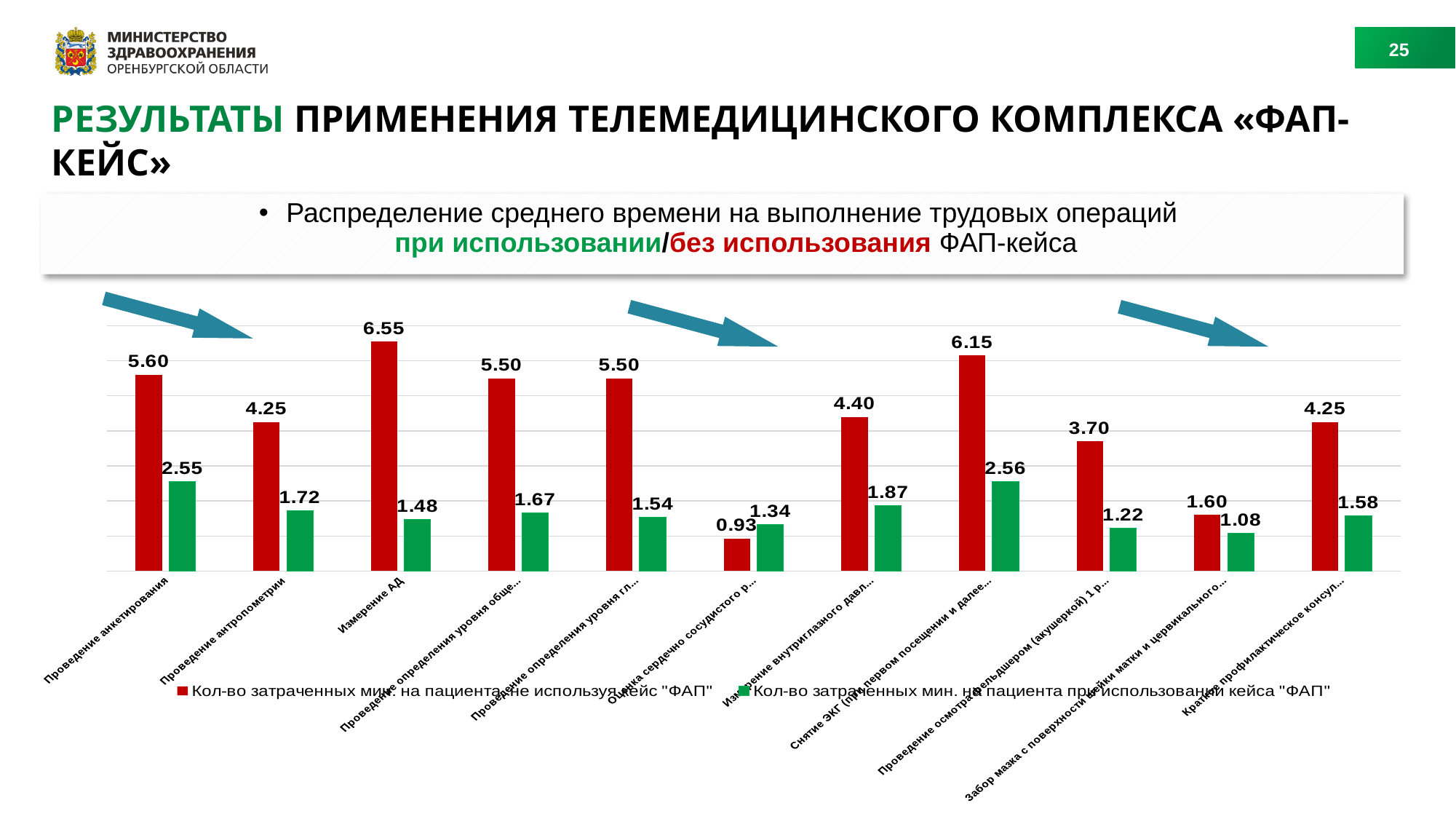
What is the value of the red series (without the "ФАП" case) for "Проведение анкетирования"? 5.60 What colour are the bars for the series "Кол-во затраченных мин. на пациента при использовании кейса "ФАП""? green What is the value of the green series (using the "ФАП" case) for "Проведение анкетирования"? 2.55 How many categories are plotted on the x axis of the chart? 11 What is the difference between the red and green values for "Измерение АД"? 5.07 What is the value of the green series for "Проведение антропометрии"? 1.72 What type of chart is shown on the slide? bar chart How many series does the chart legend list? 2 Which category has the highest value in the red series (without the "ФАП" case)? Измерение АД What is the lowest value shown in the red series? 0.93 What is the value of the red series for "Измерение АД"? 6.55 For "Проведение антропометрии", which is larger: the red series value or the green series value? the red series (4.25)